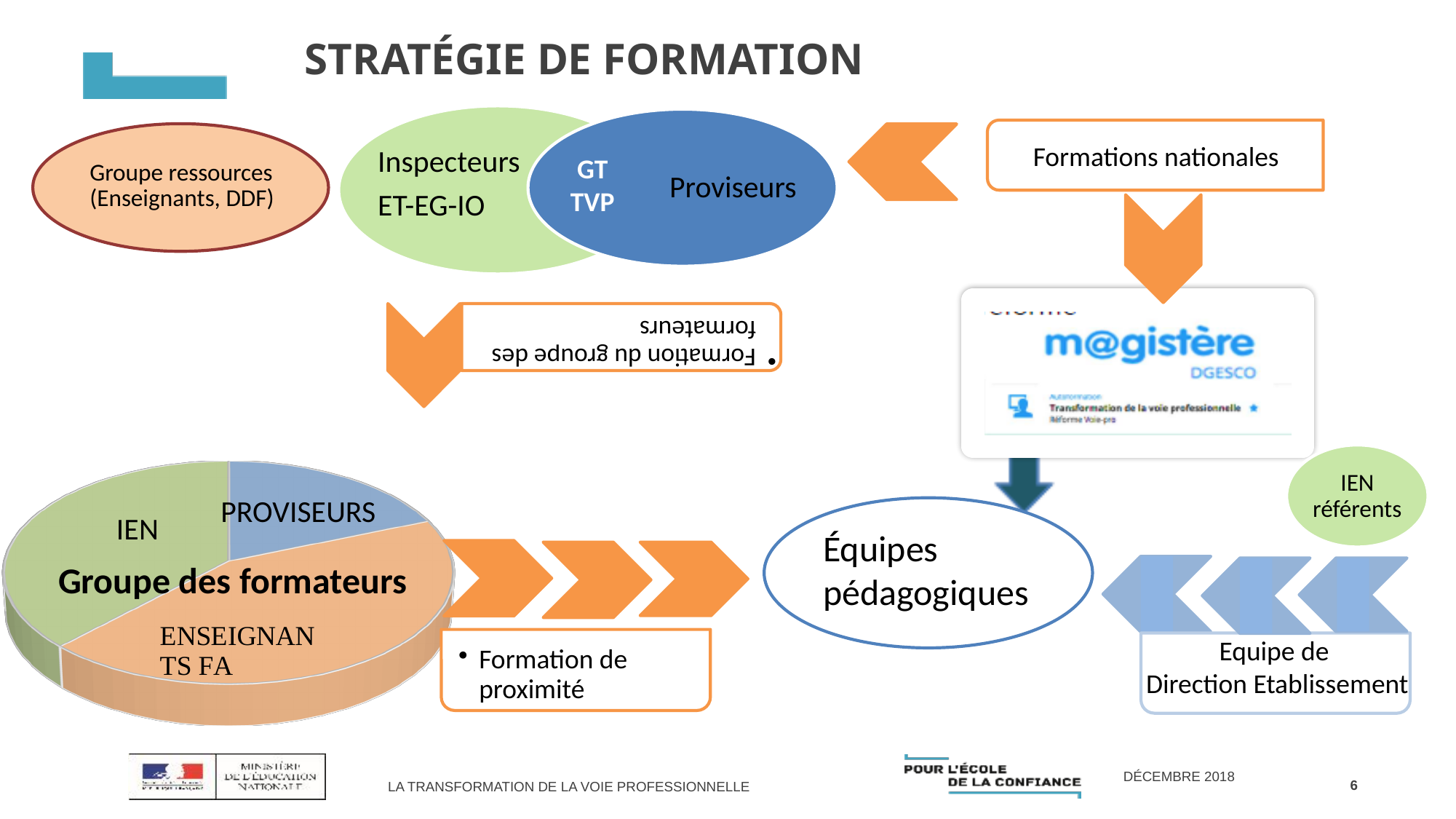
What colour is the ENSEIGNANTS FA slice of the pie chart? orange What kind of chart is shown on the slide? pie chart Which slice of the pie chart is the smallest? PROVISEURS How many slices does the pie chart have? 3 What label is written across the pie chart? Groupe des formateurs In the pie chart, which slice is larger, IEN or PROVISEURS? IEN